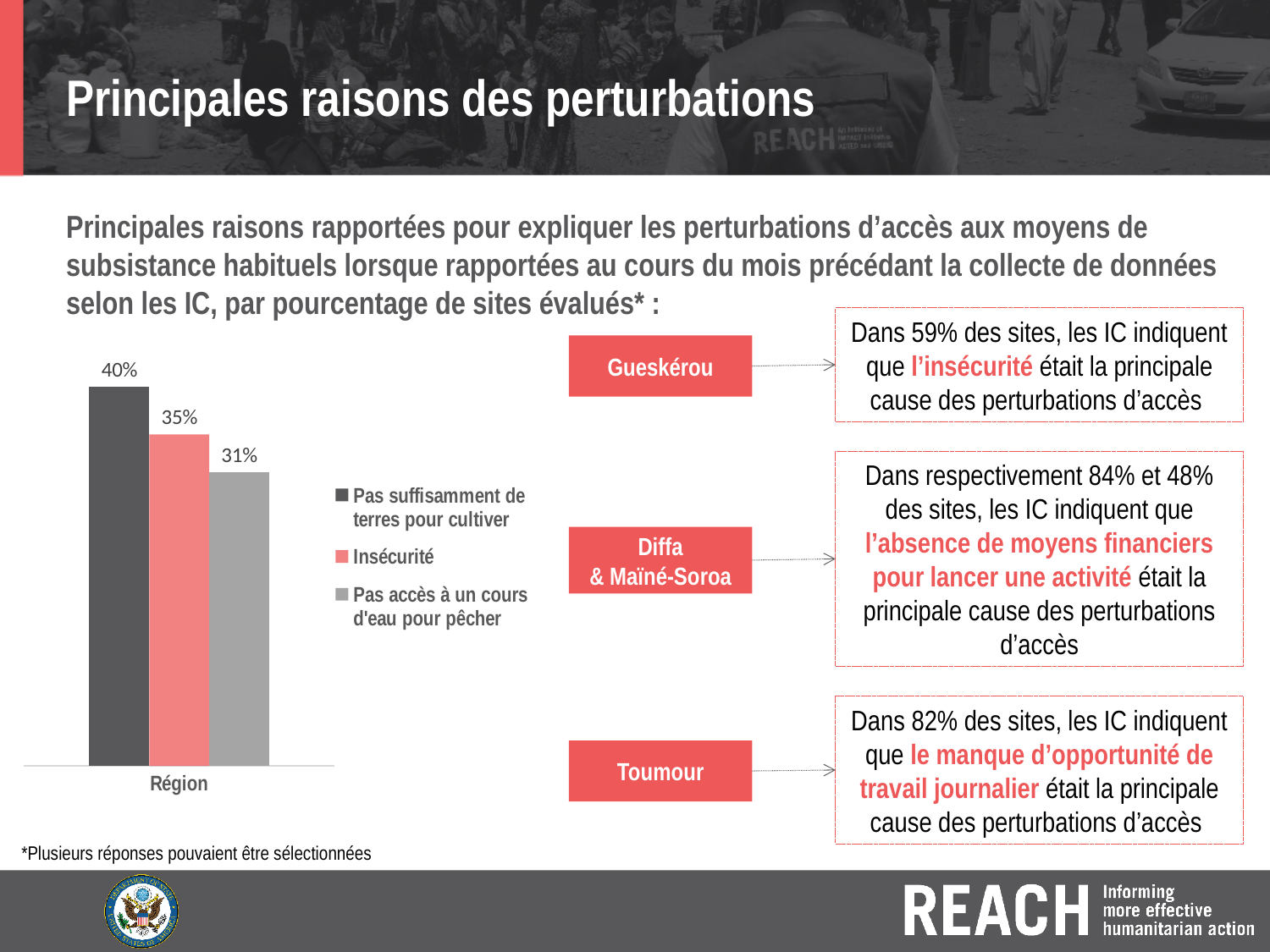
What is the difference between the values for "Pas suffisamment de terres pour cultiver" and "Insécurité"? 5% What is the value for "Pas suffisamment de terres pour cultiver" in the Région bar chart? 40% What is the value for "Pas accès à un cours d'eau pour pêcher" in the Région bar chart? 31% What is the category label on the x axis of the bar chart? Région What kind of chart is shown on the slide? Bar chart What is the difference between the values for "Insécurité" and "Pas accès à un cours d'eau pour pêcher"? 4% What is the value for "Insécurité" in the Région bar chart? 35% Which series has the highest value in the Région bar chart? Pas suffisamment de terres pour cultiver Which series has the lowest value in the Région bar chart? Pas accès à un cours d'eau pour pêcher Which is larger: the value for "Insécurité" or the value for "Pas accès à un cours d'eau pour pêcher"? Insécurité How many series does the legend of the bar chart list? 3 How many categories are shown on the x axis of the bar chart? 1